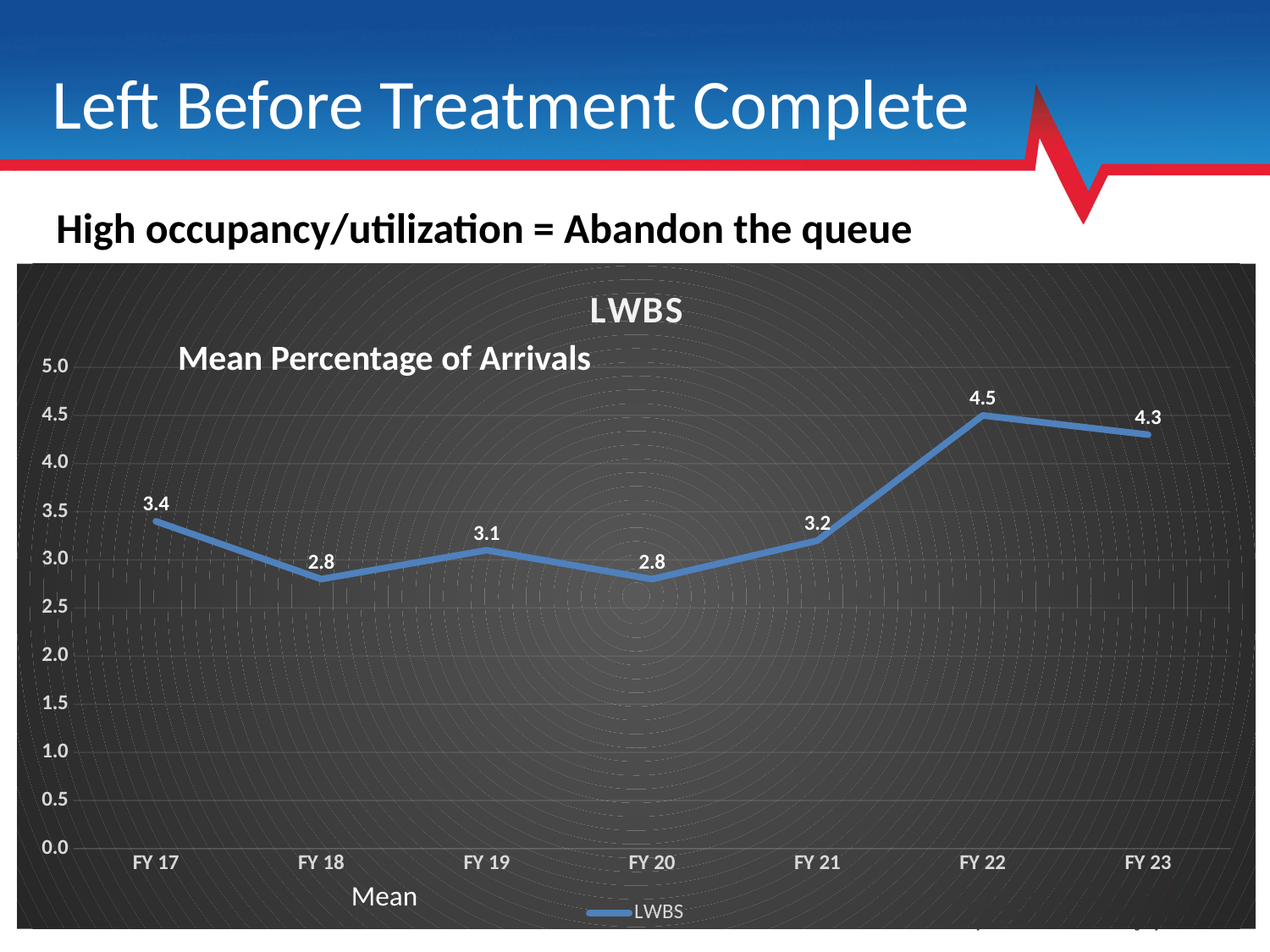
What kind of chart is shown on the slide? line chart What is the difference between the LWBS values for FY 22 and FY 21? 1.3 What is the LWBS value for FY 20? 2.8 How many fiscal years are plotted on the chart? 7 Which fiscal year has the highest LWBS value? FY 22 Does the LWBS value rise or fall from FY 20 to FY 22? rise What is the difference between the LWBS values for FY 23 and FY 18? 1.5 Which is larger, the LWBS value for FY 19 or for FY 21? FY 21 What is the LWBS value for FY 17? 3.4 What is the LWBS value for FY 22? 4.5 Is the LWBS value for FY 23 greater or less than 4.0? greater How many series does the legend list? 1